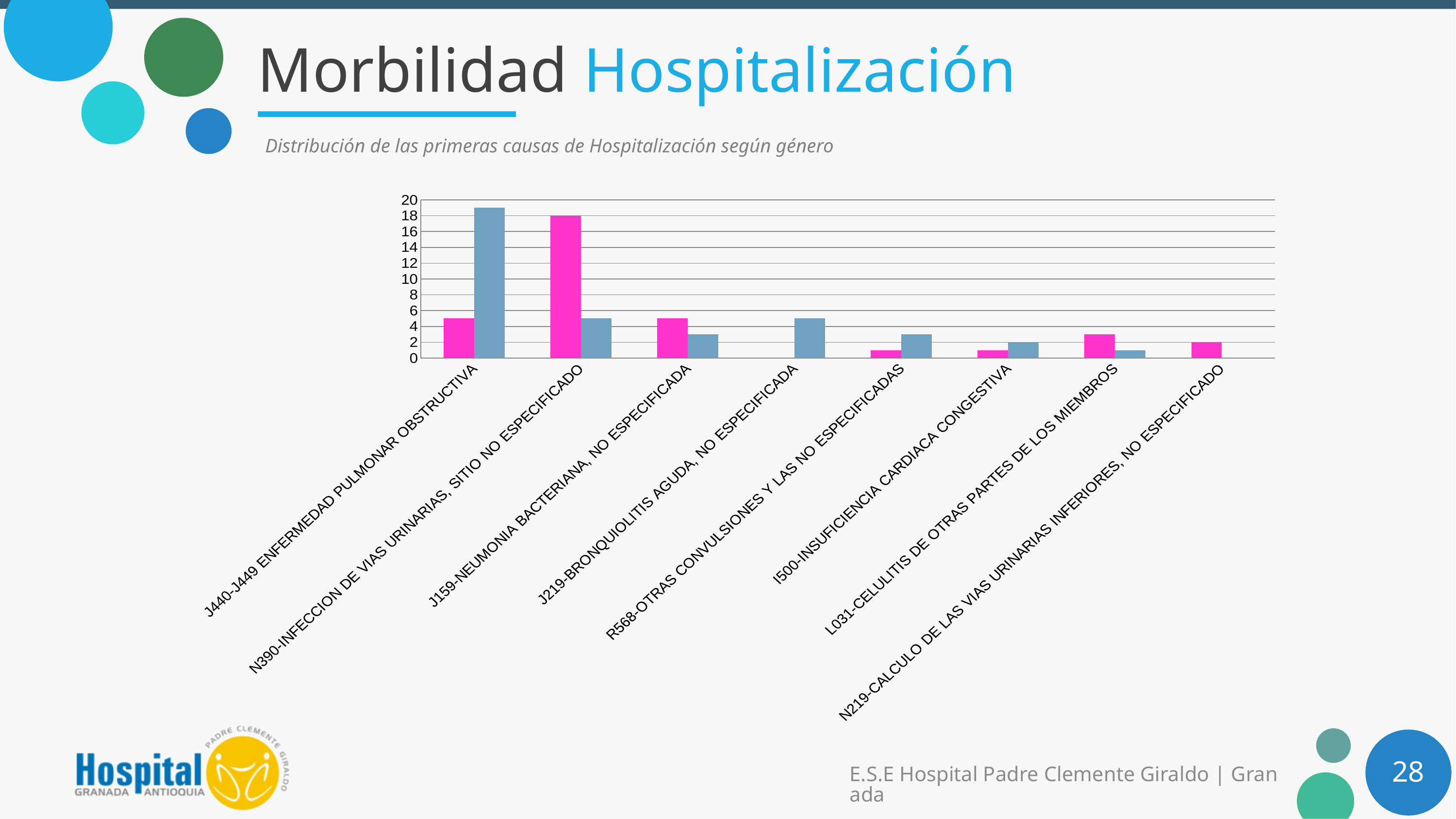
Is the value of the blue-grey bar for J440-J449 ENFERMEDAD PULMONAR OBSTRUCTIVA greater or less than 18? greater What is the subtitle written above the chart? Distribución de las primeras causas de Hospitalización según género For N390-INFECCION DE VIAS URINARIAS, SITIO NO ESPECIFICADO, which bar is larger, the pink one or the blue-grey one? pink What is the value of the pink bar for N219-CALCULO DE LAS VIAS URINARIAS INFERIORES, NO ESPECIFICADO? 2 What kind of chart is shown on the slide? bar chart Is the value of the blue-grey bar for J219-BRONQUIOLITIS AGUDA, NO ESPECIFICADA greater or less than 4? greater Which category has the tallest pink bar? N390-INFECCION DE VIAS URINARIAS, SITIO NO ESPECIFICADO How many diagnosis categories are shown on the x axis of the chart? 8 What is the value of the pink bar for N390-INFECCION DE VIAS URINARIAS, SITIO NO ESPECIFICADO? 18 What is the value of the blue-grey bar for I500-INSUFICIENCIA CARDIACA CONGESTIVA? 2 What is the difference between the pink bar for N390-INFECCION DE VIAS URINARIAS, SITIO NO ESPECIFICADO and the pink bar for N219-CALCULO DE LAS VIAS URINARIAS INFERIORES, NO ESPECIFICADO? 16 Which category has the tallest blue-grey bar? J440-J449 ENFERMEDAD PULMONAR OBSTRUCTIVA